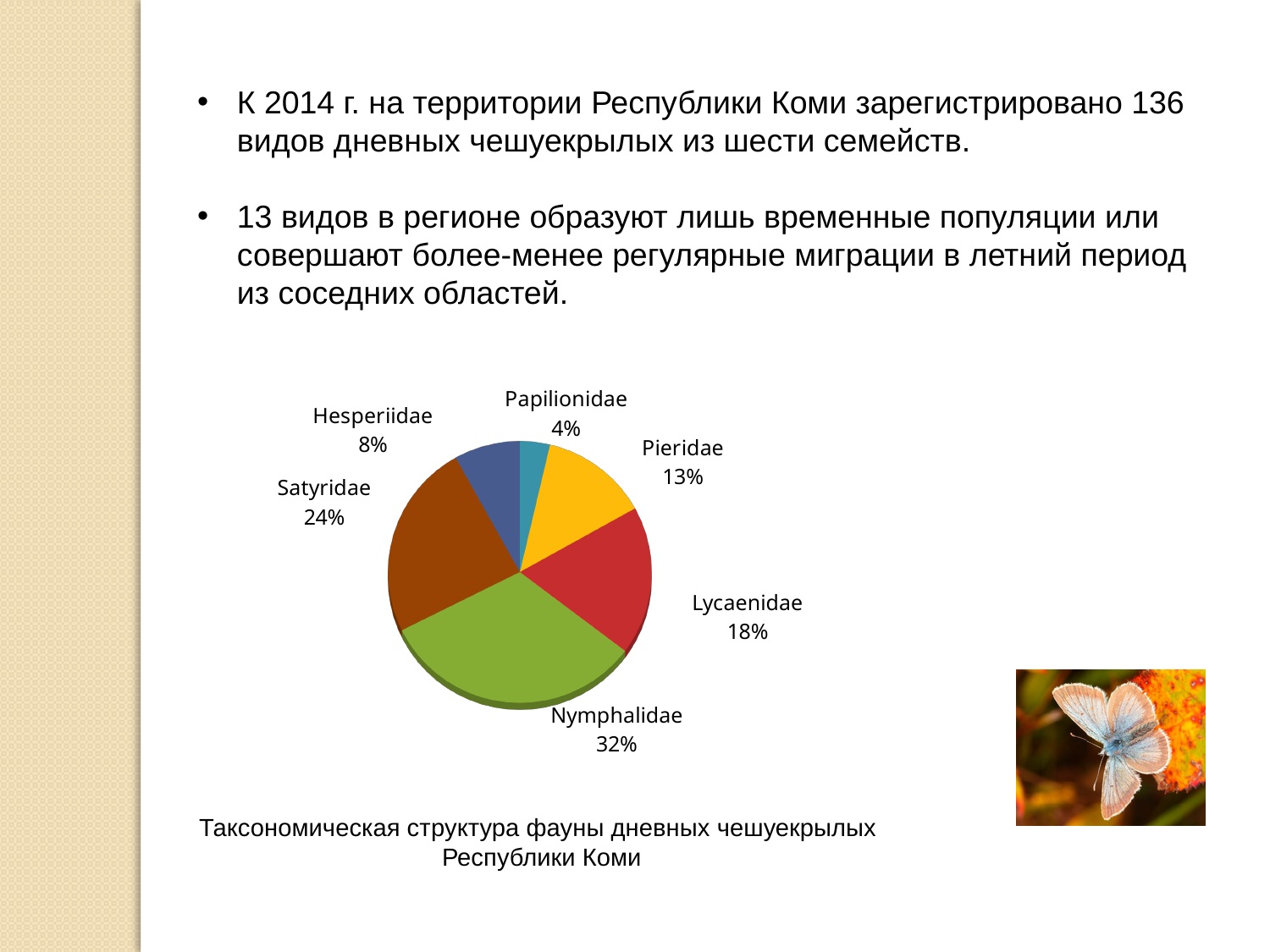
What is the value shown for Lycaenidae? 18% What is the value shown for Pieridae? 13% Which is larger, the share for Lycaenidae or the share for Pieridae? Lycaenidae What share of the pie does Nymphalidae have? 32% What share of the pie does Satyridae have? 24% What is the value shown for Hesperiidae? 8% What is the caption below the pie chart? Таксономическая структура фауны дневных чешуекрылых Республики Коми What kind of chart is shown on the slide? pie chart How many families (slices) are shown in the pie chart? 6 Which family has the largest slice of the pie? Nymphalidae Which family has the smallest slice of the pie? Papilionidae What is the difference in percentage points between Nymphalidae and Satyridae? 8